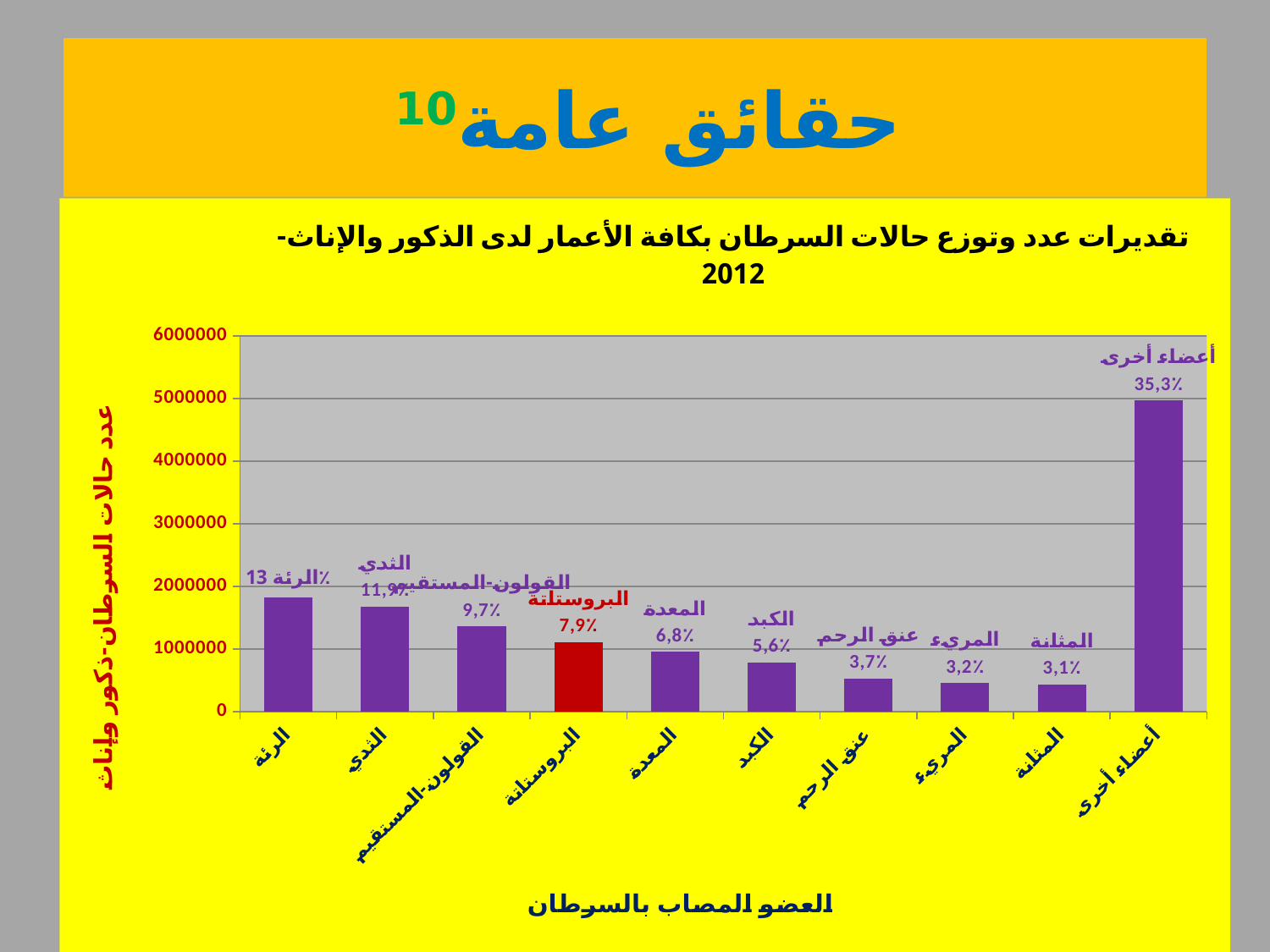
What percentage is shown for الكبد (liver)? 5,6% Which category has the lowest percentage label? المثانة (3,1%) What type of chart is shown on the slide? bar chart Is the number of cases for أعضاء أخرى greater or less than 4000000? greater Which category has the highest number of cancer cases? أعضاء أخرى Which has more cases, القولون-المستقيم or عنق الرحم? القولون-المستقيم Is the number of cases for الرئة greater or less than 2000000? less How many organ categories are shown on the x axis? 10 What percentage is shown for الرئة (lung)? 13% What percentage is shown for البروستاتة (prostate)? 7,9% What is the difference between the percentage for الثدي and the percentage for المعدة? 5,1% What percentage is shown for أعضاء أخرى (other organs)? 35,3%